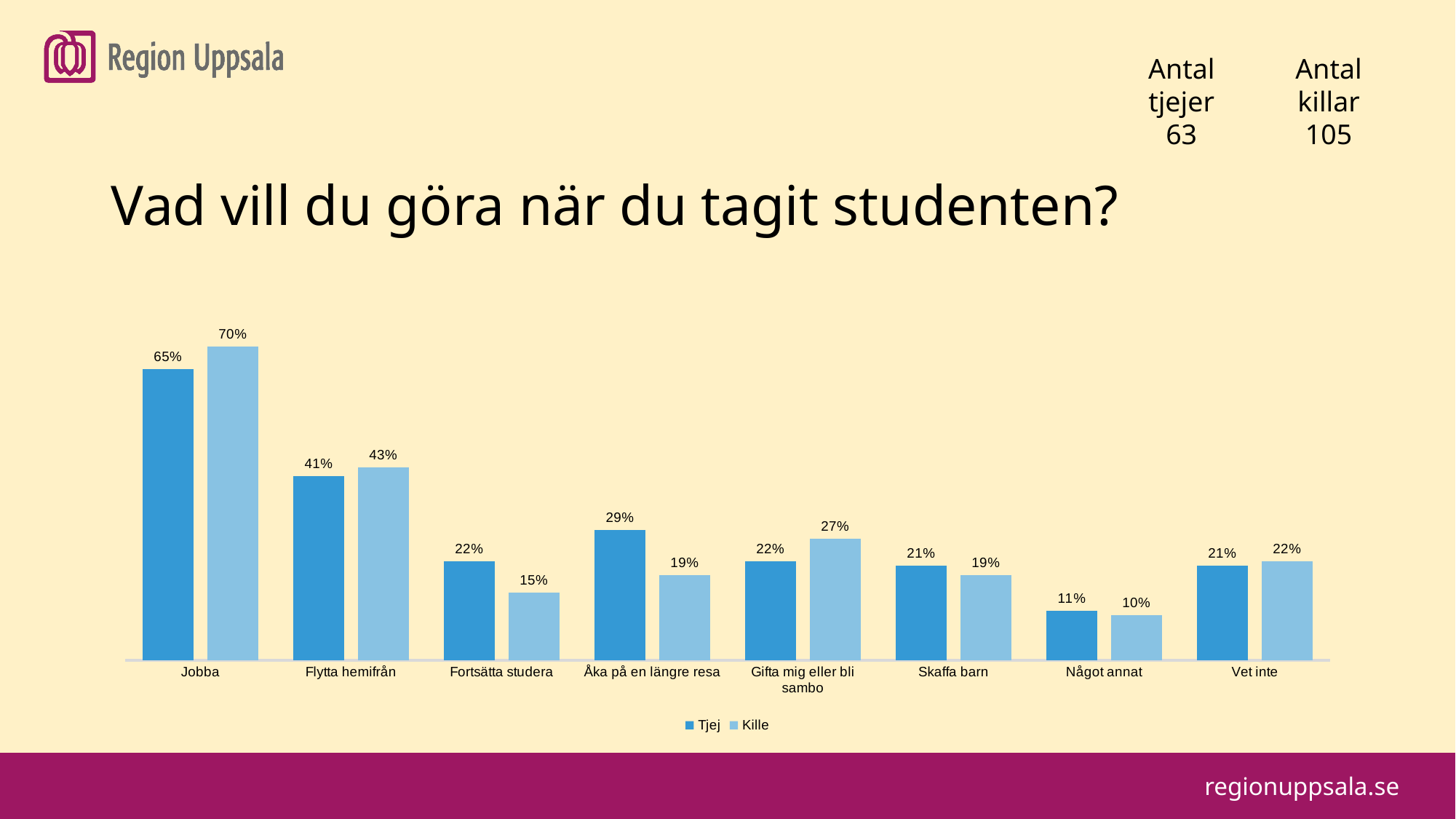
Which category has the lowest value for Tjej? Något annat What is the title of the chart on the slide? Vad vill du göra när du tagit studenten? What kind of chart is shown on the slide? Bar chart How many series does the legend list? 2 What is the value for Tjej in the Jobba category? 65% What is the value for Kille in the Fortsätta studera category? 15% Which category has the highest value for Kille? Jobba What is the difference between the Tjej and Kille values for Åka på en längre resa? 10% Which is larger for Flytta hemifrån, the Tjej value or the Kille value? Kille What is the difference between the Kille and Tjej values for Jobba? 5% How many categories are shown on the x axis? 8 What is the value for Kille in the Gifta mig eller bli sambo category? 27%